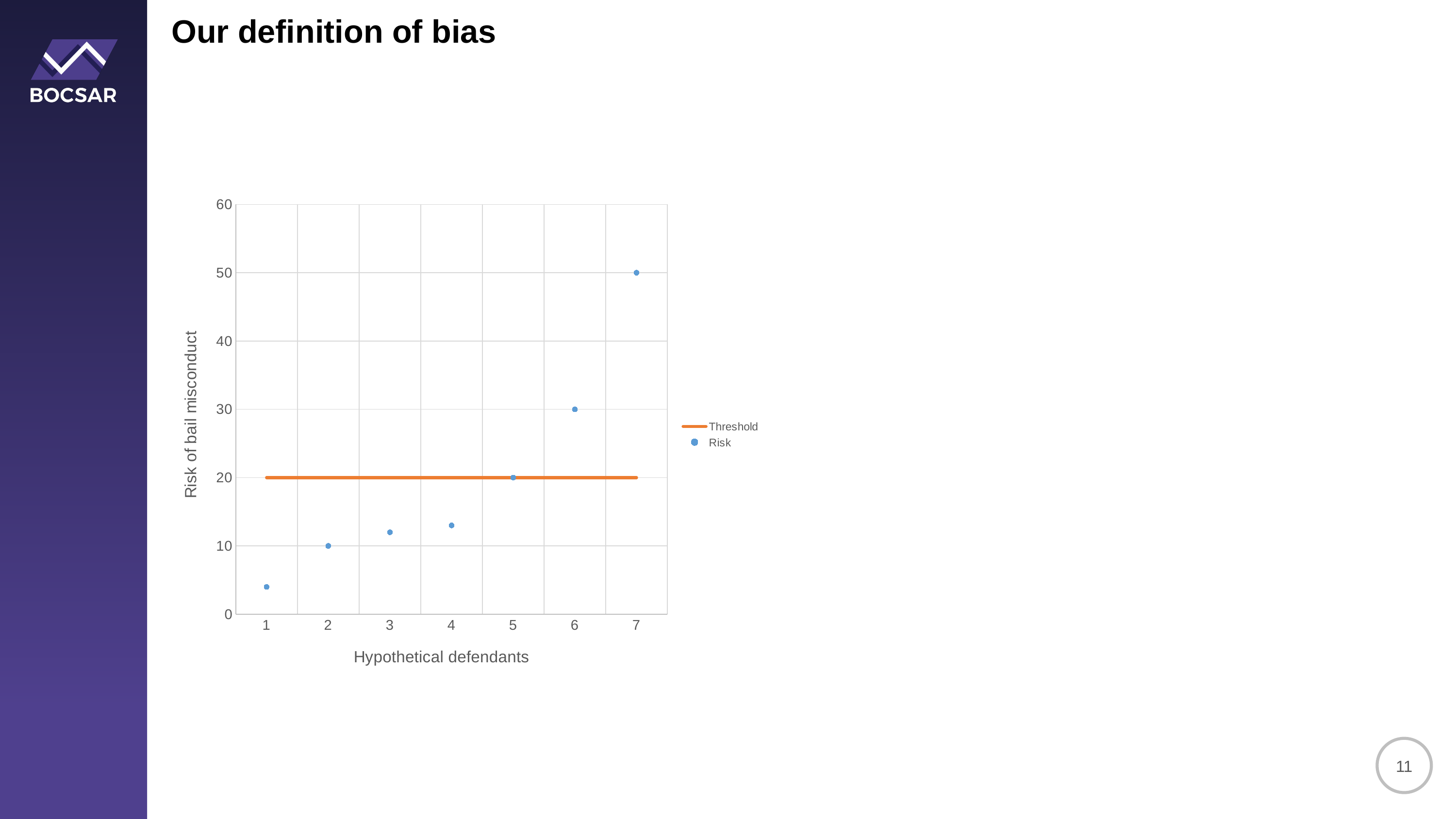
Which hypothetical defendant has the highest risk of bail misconduct? 7 Is the risk value for hypothetical defendant 1 greater or less than 10? less Is the risk value for hypothetical defendant 4 greater or less than 20? less What is the risk of bail misconduct for hypothetical defendant 2? 10 How many series does the legend list? 2 How many hypothetical defendants are plotted on the x axis? 7 What is the risk of bail misconduct for hypothetical defendant 6? 30 What kind of chart is shown on the slide? scatter chart What is the risk of bail misconduct for hypothetical defendant 7? 50 Do the risk values rise or fall as the defendant number increases from 1 to 7? rise What are the two entries listed in the legend? Threshold and Risk Which hypothetical defendant has the lowest risk of bail misconduct? 1